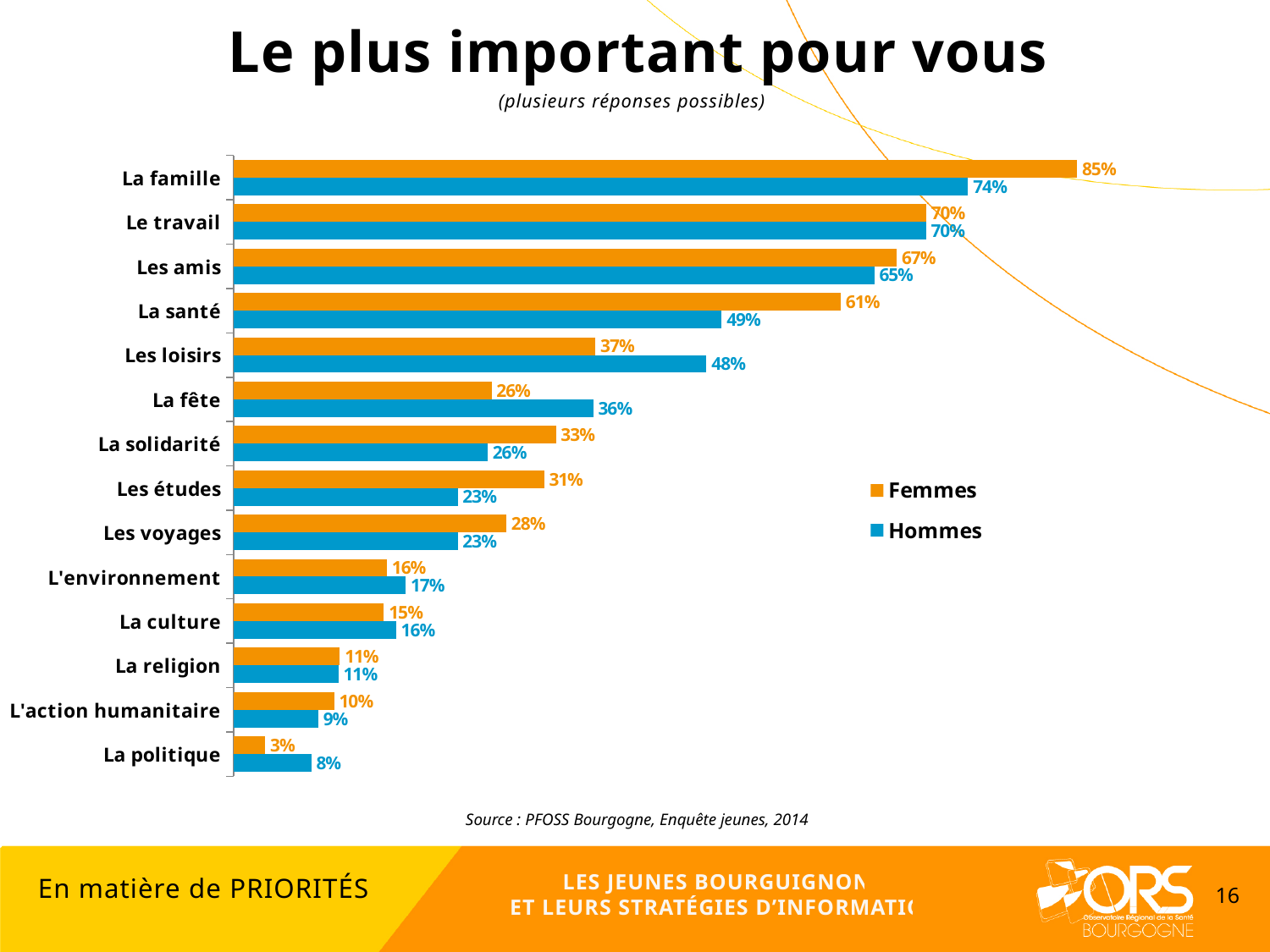
How many categories are shown on the chart? 14 What is the difference between the Femmes and Hommes values for La santé? 12% What is the value for Hommes for Les loisirs? 48% Which category has the highest value for Hommes? La famille What percentage of Hommes chose La politique? 8% What type of chart is shown on the slide? Bar chart Which is larger: the Femmes value for Les études or the Femmes value for Les voyages? Les études What percentage of Femmes chose La famille? 85% Which colour represents the Femmes series? Orange Which category has the lowest value for Femmes? La politique How many series does the legend list? 2 For La fête, which series has the larger value, Femmes or Hommes? Hommes